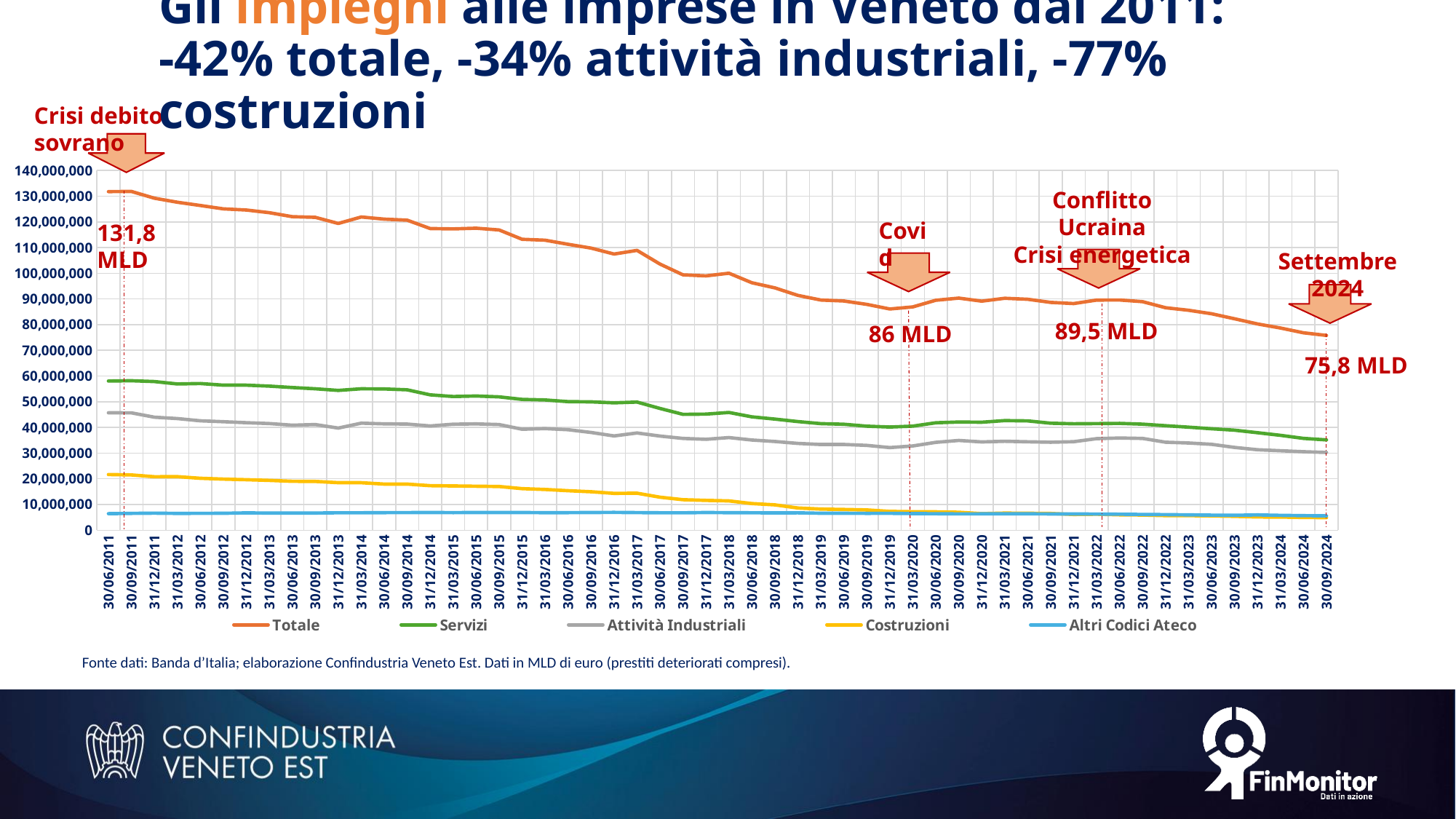
What is the value of Totale at 31/03/2020 (Covid) according to the annotation? 86 MLD How many series does the chart legend list? 5 Is the value for Attività Industriali at 30/09/2024 greater or less than 40,000,000? less What is the value of Totale at 31/03/2022 (Conflitto Ucraina / Crisi energetica) according to the annotation? 89,5 MLD What kind of chart is shown on the slide? line chart What colour is the Totale line in the chart? orange By how much did Totale fall between 30/06/2011 (131,8 MLD) and 30/09/2024 (75,8 MLD)? 56 MLD What is the value of Totale at 30/09/2024 according to the annotation? 75,8 MLD At 30/06/2011, which series is lower: Costruzioni or Altri Codici Ateco? Altri Codici Ateco Is the value for Servizi at 30/06/2011 greater or less than 50,000,000? greater Does the Totale line rise or fall from 2011 to 2024? fall What is the value of Totale at 30/06/2011 according to the annotation? 131,8 MLD